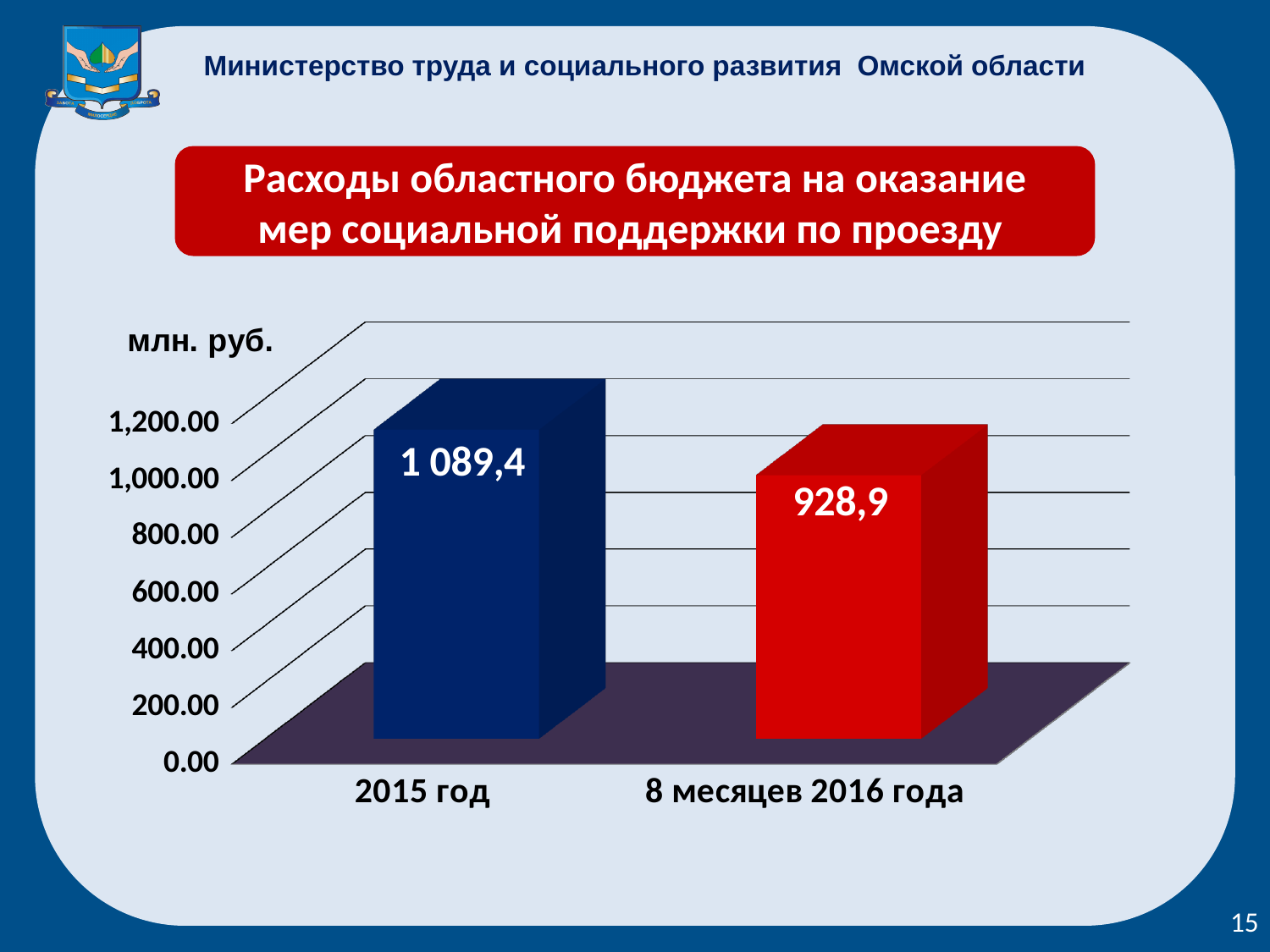
Is the value for 2015 год greater or less than 1,000.00? greater Which is larger: the value for 2015 год or the value for 8 месяцев 2016 года? 2015 год Which category has the highest value? 2015 год What is the value for 8 месяцев 2016 года? 928,9 What is the difference between the values for 2015 год and 8 месяцев 2016 года? 160,5 Do the values rise or fall from 2015 год to 8 месяцев 2016 года? fall What is the value for 2015 год? 1 089,4 What kind of chart is shown on the slide? bar chart What unit is shown on the chart's axis label? млн. руб. Is the value for 8 месяцев 2016 года greater or less than 1,000.00? less How many categories are shown on the chart? 2 Which category has the lowest value? 8 месяцев 2016 года